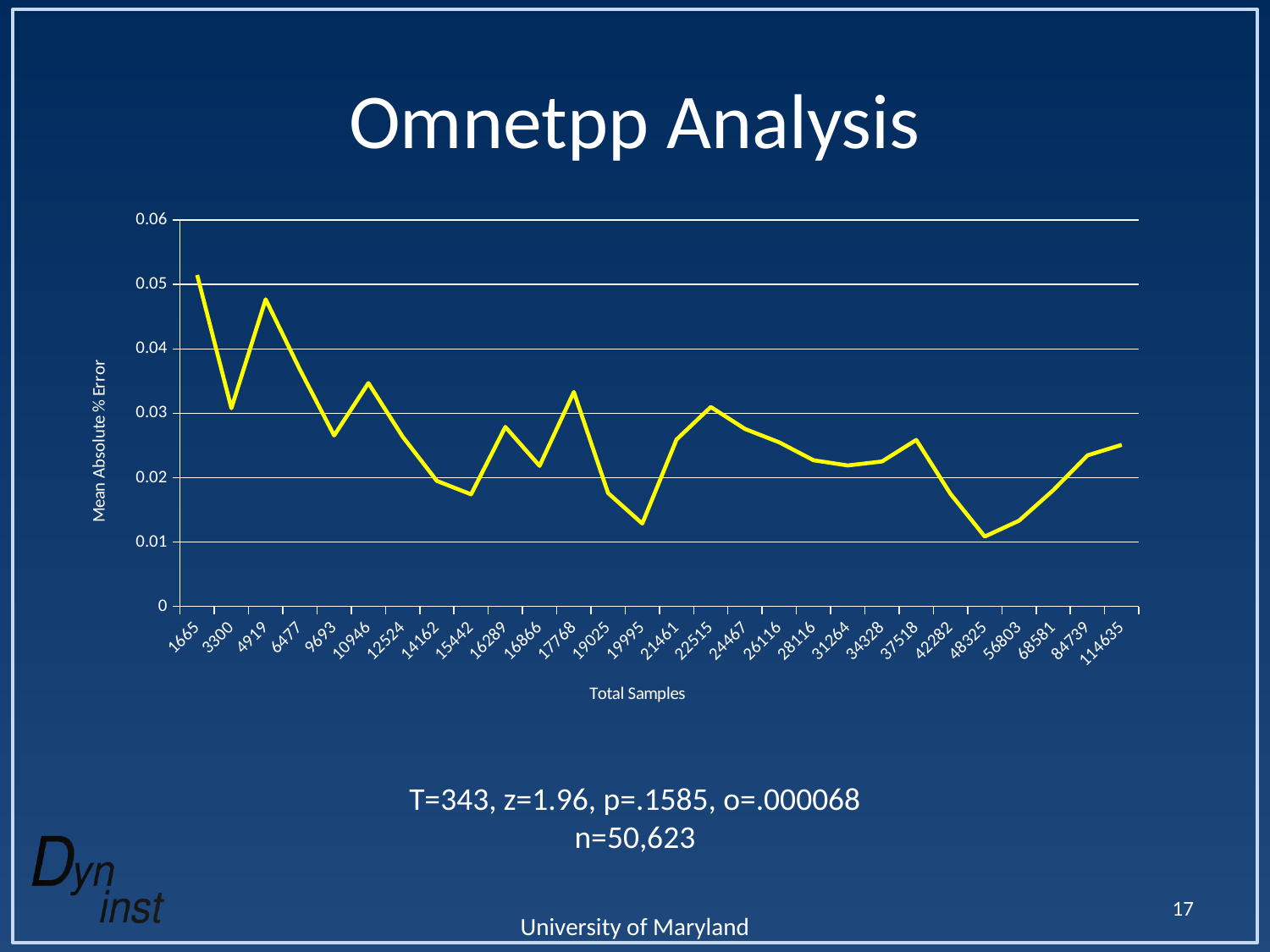
Is the value for 15442 greater or less than 0.02? less What kind of chart is shown on the slide? line chart Overall, do the values rise or fall as Total Samples increases along the x axis? fall Which has the larger Mean Absolute % Error, 17768 or 19995? 17768 Which has the larger Mean Absolute % Error, 1665 or 114635? 1665 What is the label of the y axis? Mean Absolute % Error Is the value for 9693 greater or less than 0.03? less Which Total Samples value has the highest Mean Absolute % Error? 1665 Is the value for 4919 greater or less than 0.04? greater How many data points are plotted along the x axis? 28